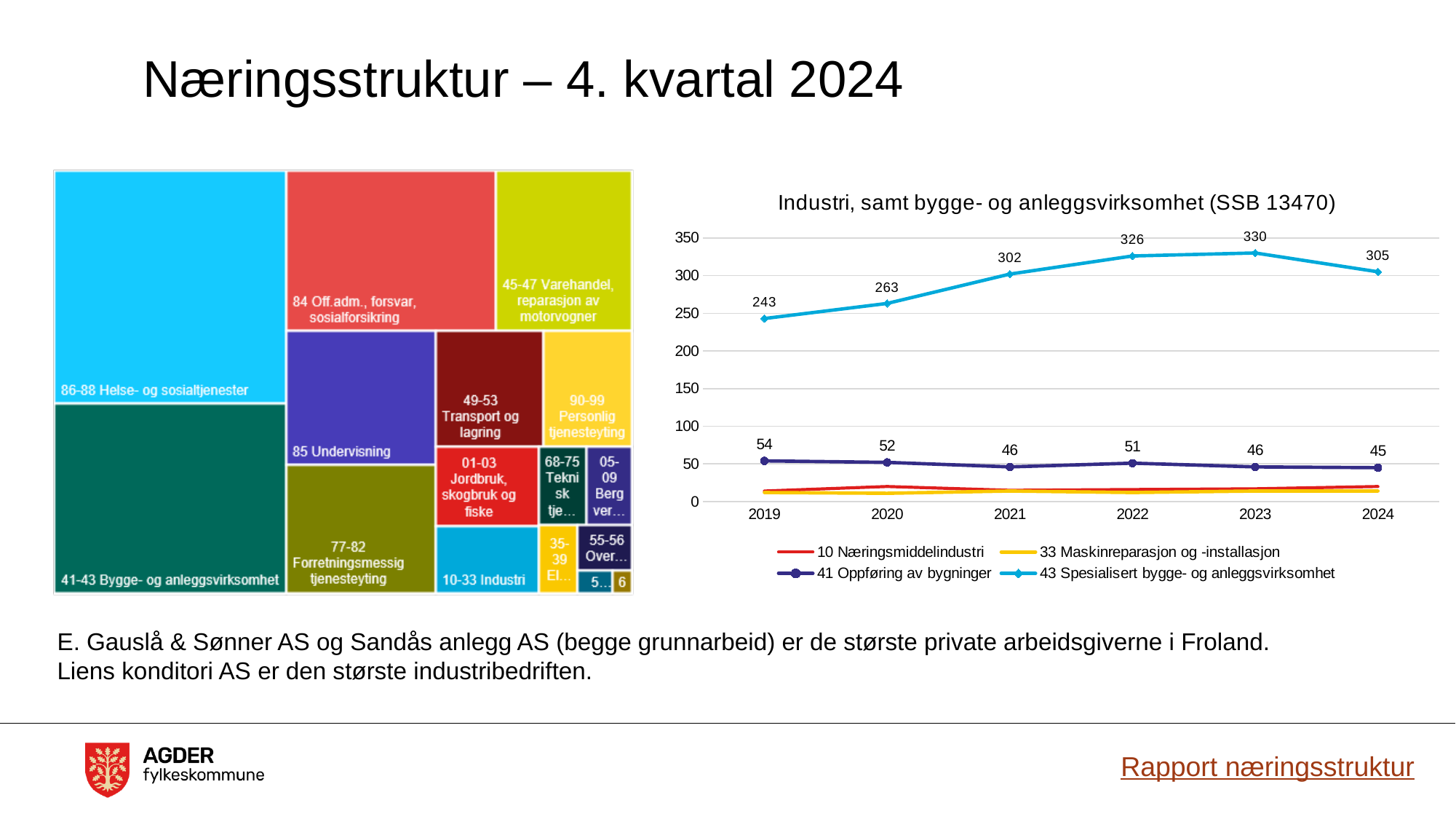
How many years are shown on the x axis of the line chart on the right? 6 In the line chart on the right, is the value for 10 Næringsmiddelindustri in 2020 greater or less than 50? less How many series does the legend of the line chart on the right list? 4 What is the title of the line chart on the right of the slide? Industri, samt bygge- og anleggsvirksomhet (SSB 13470) In the line chart on the right, in which year does 43 Spesialisert bygge- og anleggsvirksomhet reach its highest value? 2023 In the line chart on the right, by how much did 43 Spesialisert bygge- og anleggsvirksomhet fall from 2023 to 2024? 25 In the line chart on the right, in which year is the value for 41 Oppføring av bygninger lowest? 2024 What kind of chart is the chart on the right of the slide? line chart In the line chart 'Industri, samt bygge- og anleggsvirksomhet (SSB 13470)', what is the value for 43 Spesialisert bygge- og anleggsvirksomhet in 2021? 302 In the line chart on the right, is the value for 41 Oppføring av bygninger larger in 2020 or in 2022? 2020 In the line chart on the right, does 43 Spesialisert bygge- og anleggsvirksomhet rise or fall from 2019 to 2023? rise In the line chart on the right, what is the value for 41 Oppføring av bygninger in 2019? 54